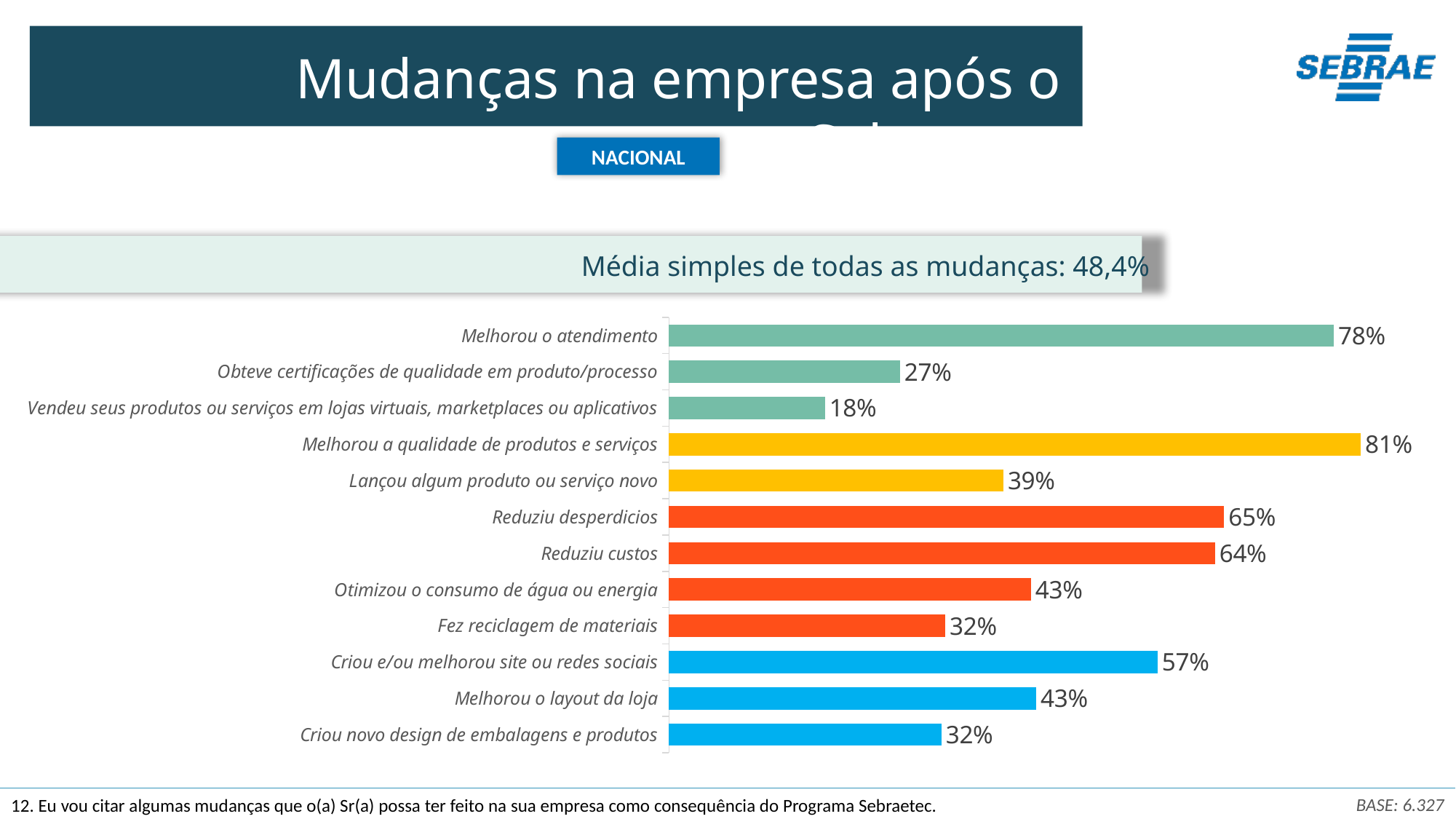
What is the difference between "Reduziu desperdicios" and "Fez reciclagem de materiais"? 33 percentage points Which is larger, "Obteve certificações de qualidade em produto/processo" or "Fez reciclagem de materiais"? Fez reciclagem de materiais What is the value for "Lançou algum produto ou serviço novo"? 39% Which category has the highest value? Melhorou a qualidade de produtos e serviços How many categories are shown in the chart? 12 What is the difference between "Melhorou a qualidade de produtos e serviços" and "Melhorou o atendimento"? 3 percentage points What is the value for "Melhorou o atendimento"? 78% What kind of chart is shown on the slide? Bar chart What percentage is shown for "Criou e/ou melhorou site ou redes sociais"? 57% Which category has the lowest value? Vendeu seus produtos ou serviços em lojas virtuais, marketplaces ou aplicativos What is the simple average of all changes stated on the slide? 48,4% Which is larger, "Reduziu desperdicios" or "Reduziu custos"? Reduziu desperdicios